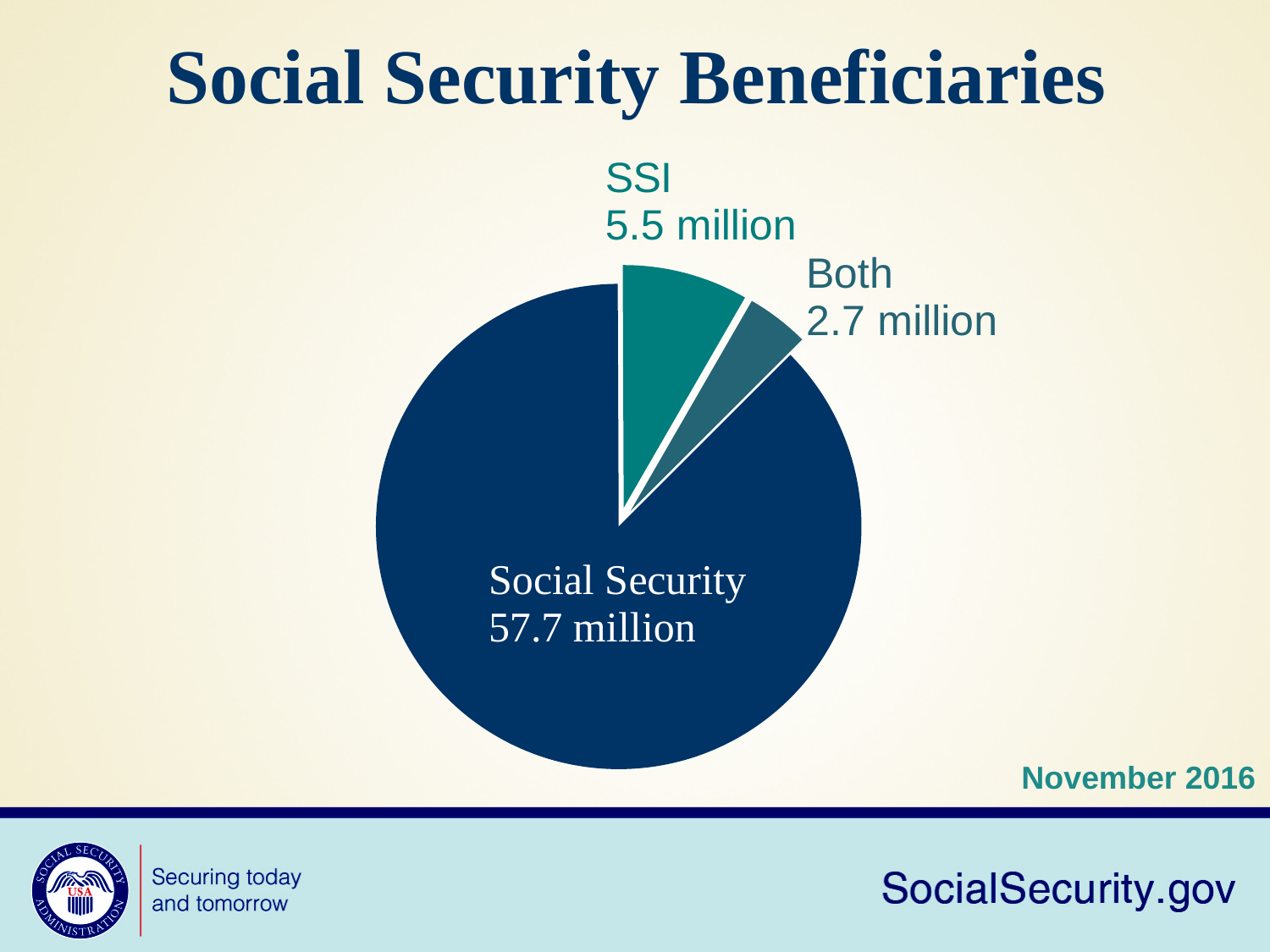
What is the difference between the Social Security value and the SSI value? 52.2 million What date is given for the data in the chart? November 2016 How many slices does the pie chart have? 3 What is the difference between the SSI value and the Both value? 2.8 million Which is larger, the SSI slice or the Both slice? SSI Which slice of the pie chart is the smallest? Both Which slice of the pie chart is the largest? Social Security How many beneficiaries are shown for Social Security? 57.7 million What kind of chart is shown on the slide? Pie chart What is the title of the chart on the slide? Social Security Beneficiaries How many beneficiaries are shown for Both? 2.7 million How many beneficiaries are shown for SSI? 5.5 million